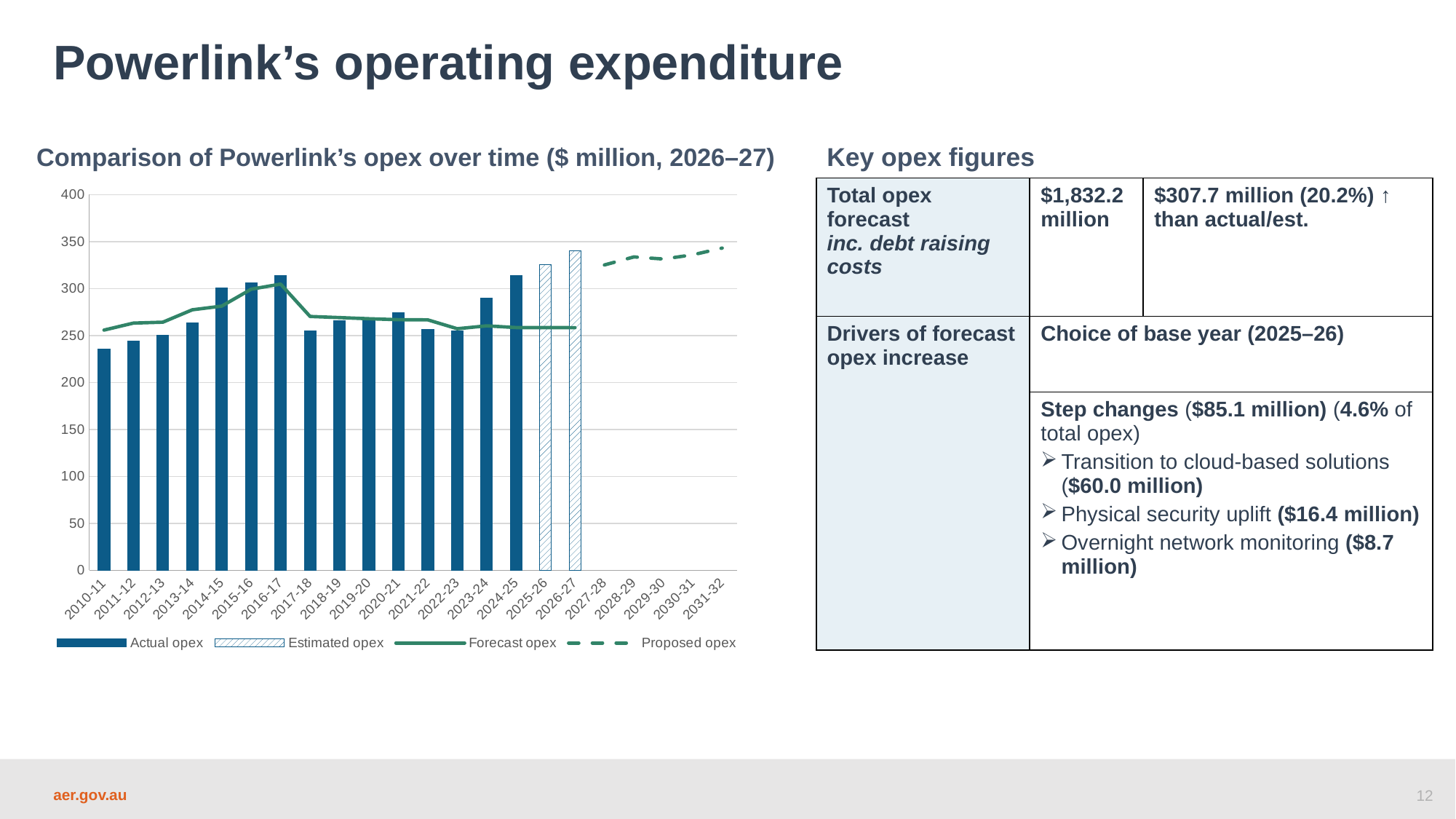
Is the actual opex bar for 2010-11 greater or less than 250? less Does the proposed opex dashed line rise or fall from 2027-28 to 2031-32? rise Is the estimated opex bar for 2026-27 greater or less than 300? greater Is the actual opex bar for 2020-21 greater or less than 300? less Which year has the tallest bar in the opex chart? 2026-27 How many year categories are shown on the x axis of the opex chart? 22 What kind of chart is used to show Powerlink's opex over time? bar chart (with line series) Which bar is taller, 2016-17 or 2017-18? 2016-17 Which year has the shortest bar in the opex chart? 2010-11 Which bar is taller, 2023-24 or 2024-25? 2024-25 How many series does the legend of the opex chart list? 4